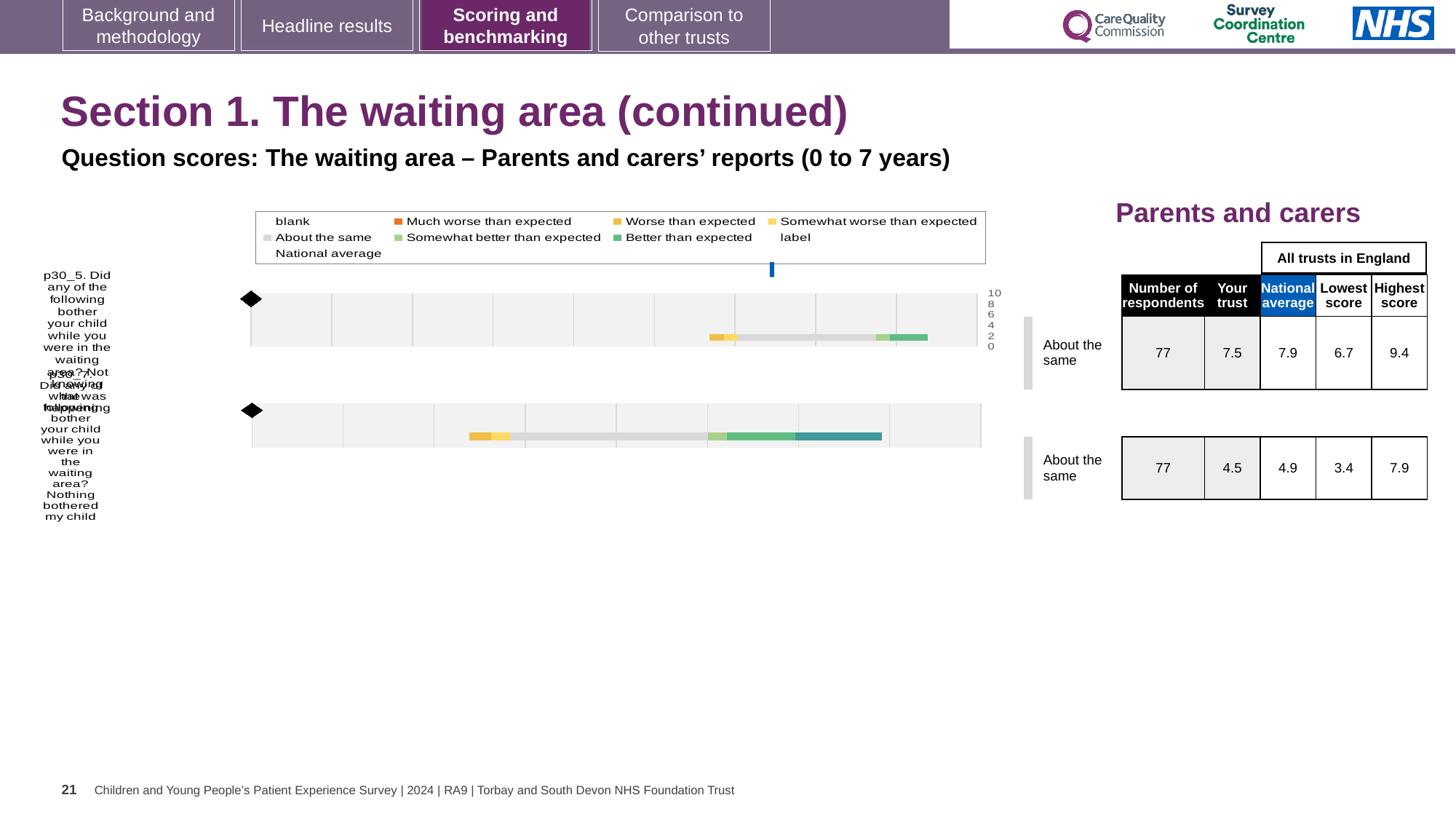
What is the lowest score among all trusts in England for question p30_7? 3.4 For question p30_7, how much higher is the national average than the trust's score? 0.4 What is the 'Your trust' score for question p30_5 (Not knowing what was happening)? 7.5 How many questions (rows) are plotted in the waiting area chart? 2 What is the national average score for question p30_7 (Nothing bothered my child)? 4.9 What is the difference between the highest and lowest scores for question p30_5? 2.7 What kind of chart is used to show the question scores for the waiting area? bar chart How many respondents answered question p30_5? 77 For question p30_5, which is larger: the trust's score or the national average? National average Is the trust's score for question p30_7 greater or less than 6? less What is the highest score among all trusts in England for question p30_5? 9.4 What benchmark category is shown for both questions on this slide? About the same